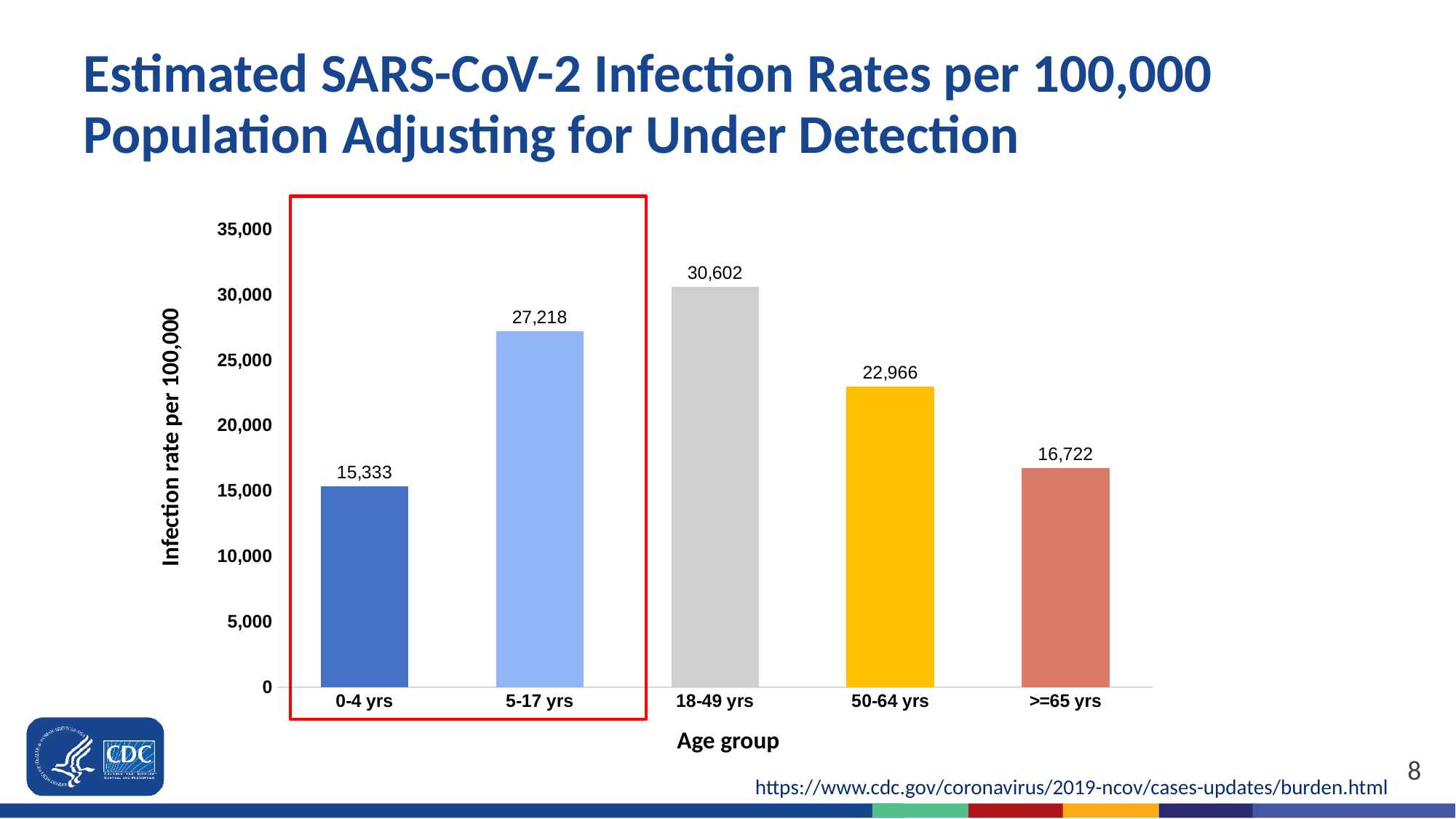
What is the estimated infection rate per 100,000 for the >=65 yrs age group? 16,722 Which age group has the highest estimated infection rate? 18-49 yrs Is the value for the 5-17 yrs age group greater or less than 25,000? greater How many age groups are shown on the chart? 5 Which two age groups are enclosed by the red box on the chart? 0-4 yrs and 5-17 yrs What kind of chart is shown on the slide? Bar chart What is the estimated infection rate per 100,000 for the 18-49 yrs age group? 30,602 Which age group has the lowest estimated infection rate? 0-4 yrs What is the estimated infection rate per 100,000 for the 0-4 yrs age group? 15,333 What is the difference between the infection rates for the 5-17 yrs and 0-4 yrs age groups? 11,885 Which has a higher infection rate, the 50-64 yrs group or the >=65 yrs group? 50-64 yrs What is the difference between the infection rates for the 18-49 yrs and 50-64 yrs age groups? 7,636